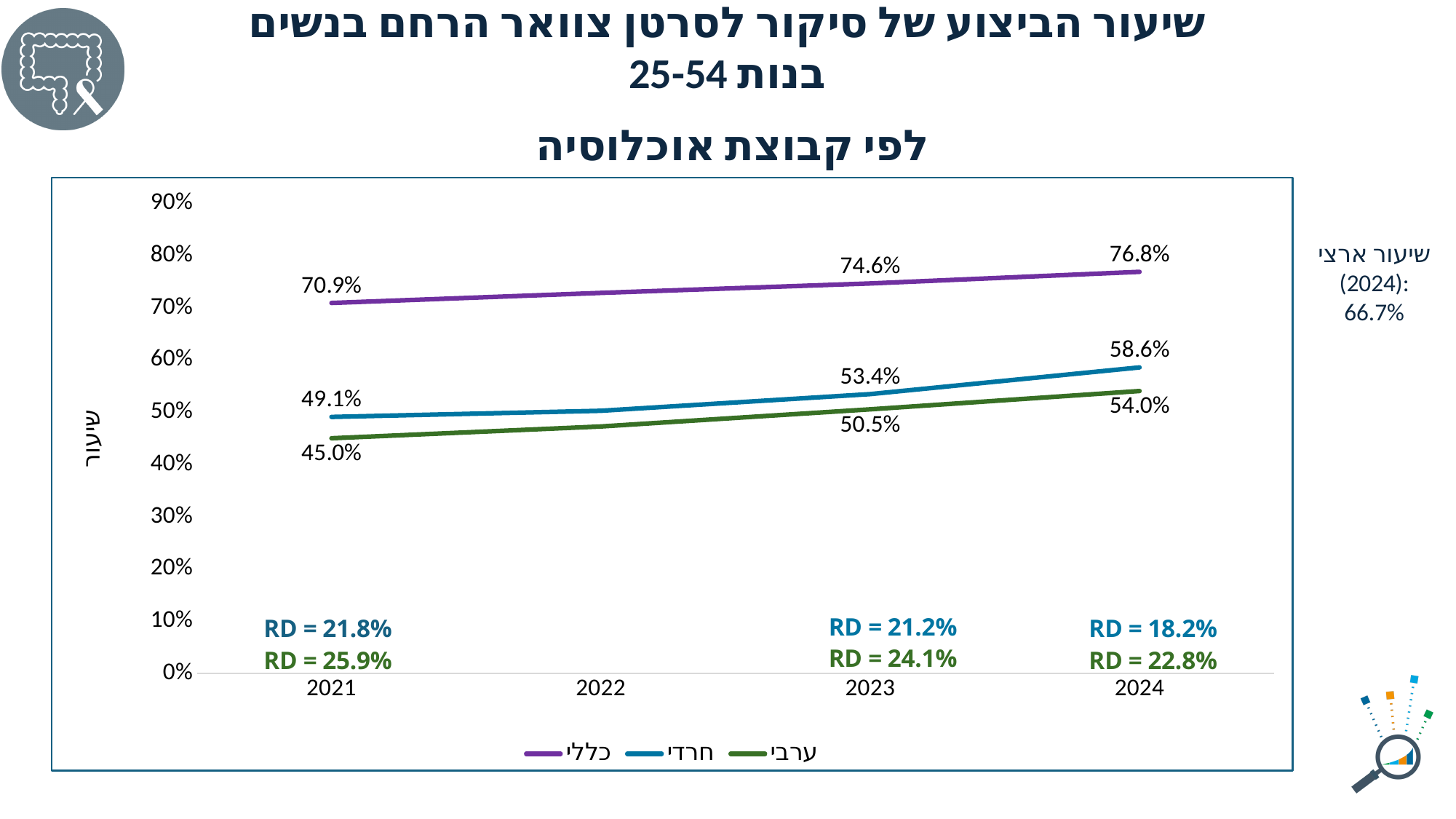
What is the value for the חרדי (Haredi) series in 2024? 58.6% Which is larger: the חרדי value in 2023 or the ערבי value in 2024? ערבי value in 2024 Is the value for the ערבי series in 2022 greater or less than 50%? less What type of chart is shown on the slide? line chart Which series has the highest value in 2024? כללי What is the value for the כללי (general) series in 2021? 70.9% What is the difference between the כללי value in 2024 and the כללי value in 2021? 5.9% Which series has the lowest value in 2021? ערבי How many series does the legend list? 3 What is the value for the ערבי (Arab) series in 2023? 50.5% What national rate (שיעור ארצי) for 2024 is noted beside the chart? 66.7% Does the חרדי series rise or fall from 2021 to 2024? rise